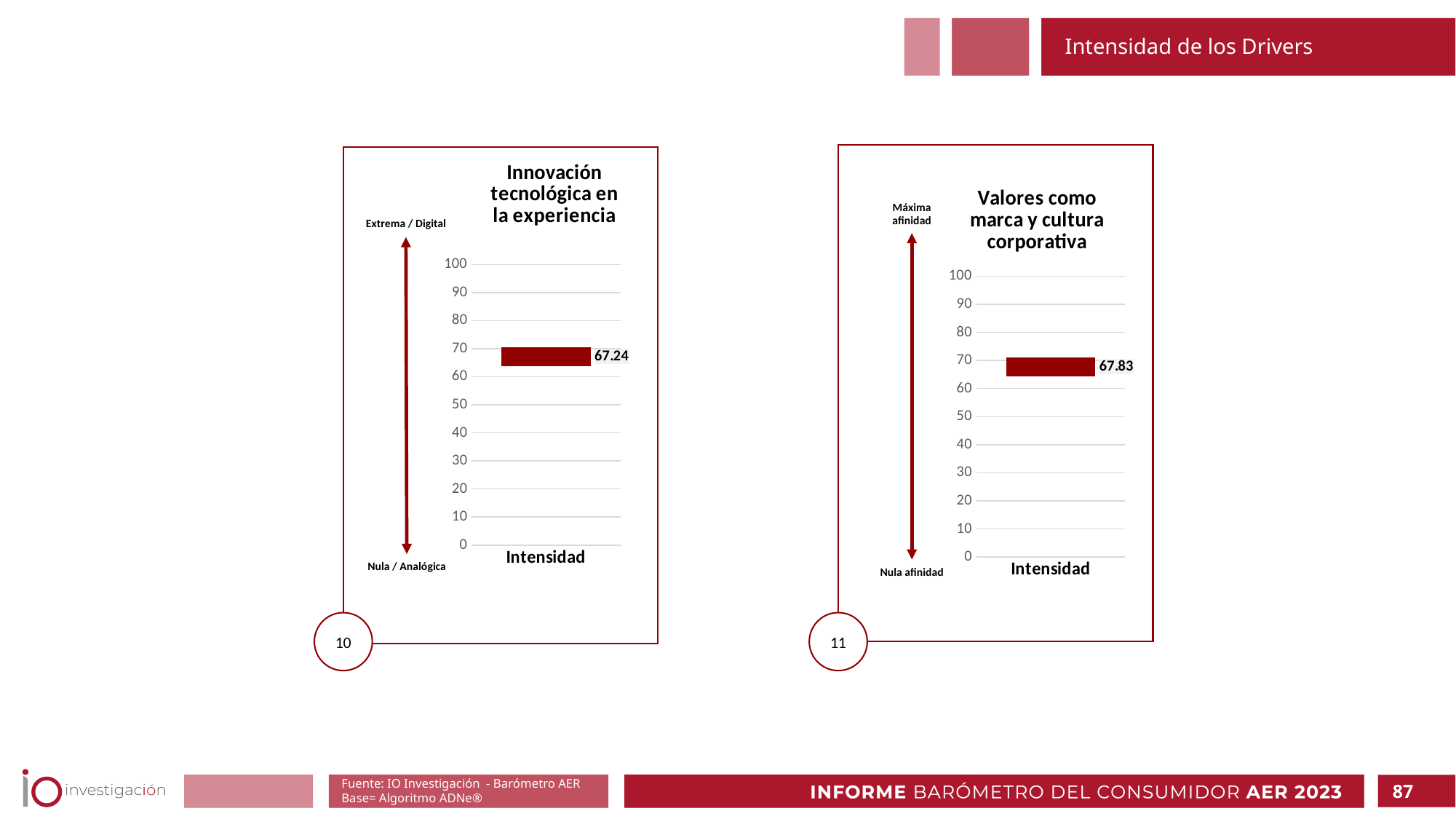
What kind of chart is the left chart, "Innovación tecnológica en la experiencia"? bar chart What kind of chart is the right chart, "Valores como marca y cultura corporativa"? bar chart Which chart shows the higher Intensidad value, "Innovación tecnológica en la experiencia" or "Valores como marca y cultura corporativa"? Valores como marca y cultura corporativa In the right chart, "Valores como marca y cultura corporativa", is the Intensidad value greater or less than 60? greater How many bars are plotted in the left chart, "Innovación tecnológica en la experiencia"? 1 In the left chart, "Innovación tecnológica en la experiencia", is the Intensidad value greater or less than 70? less In the chart titled "Valores como marca y cultura corporativa", what is the value of the Intensidad bar? 67.83 What is the category label under the bar in the right chart, "Valores como marca y cultura corporativa"? Intensidad In the chart titled "Innovación tecnológica en la experiencia", what is the value of the Intensidad bar? 67.24 How many bars are plotted in the right chart, "Valores como marca y cultura corporativa"? 1 In the left chart, "Innovación tecnológica en la experiencia", what is the maximum value shown on the vertical axis? 100 What is the difference between the Intensidad value in "Valores como marca y cultura corporativa" and the Intensidad value in "Innovación tecnológica en la experiencia"? 0.59